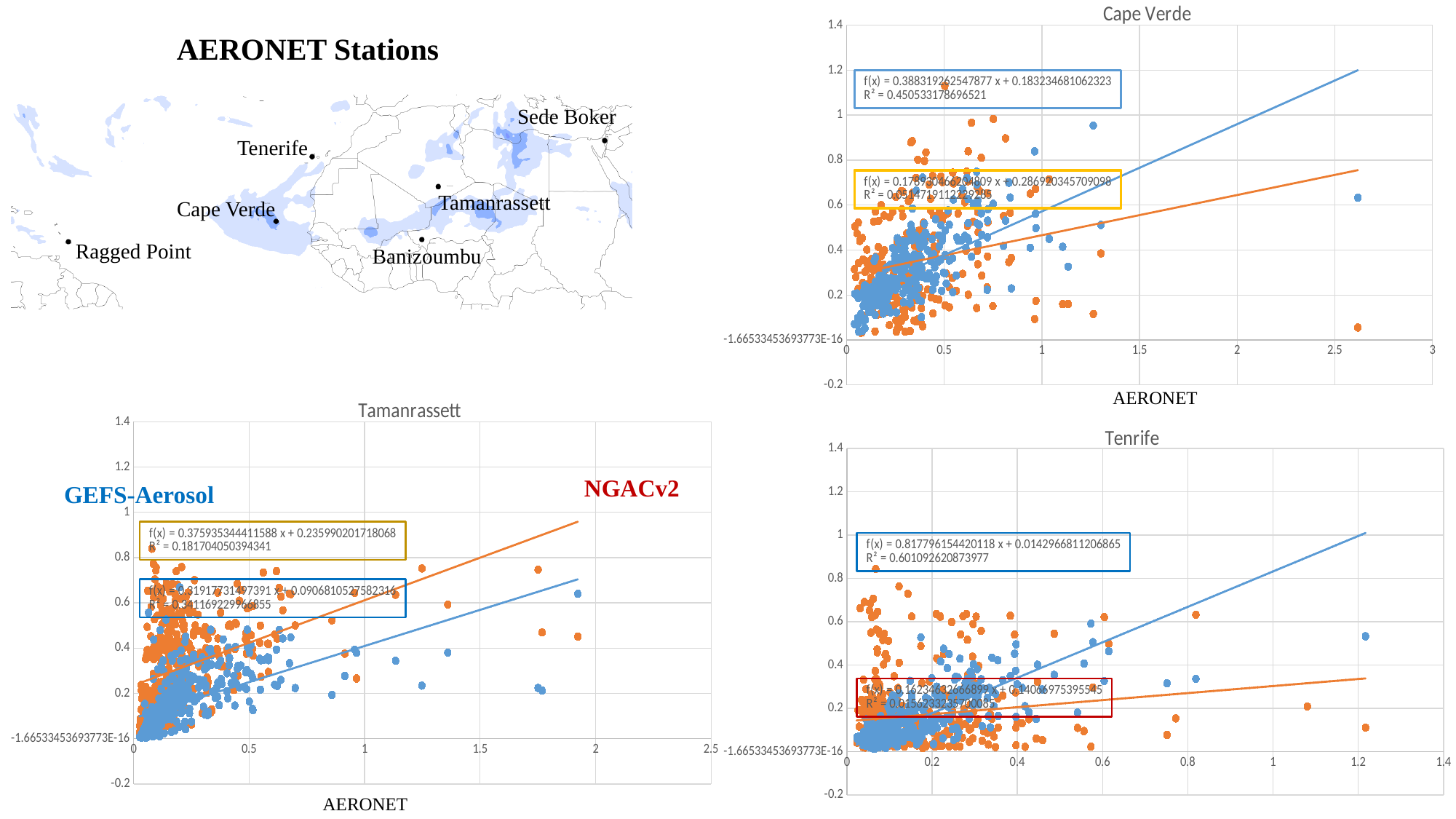
In the Tenrife chart, which fit line is steeper, the blue one or the orange one? blue In the Tenrife chart, what is the R² value shown in the blue box? 0.601092620873977 In the Cape Verde chart, what is the R² value shown in the blue box? 0.450533178696521 What kind of chart is the Cape Verde chart? scatter chart In the Tenrife chart, what is the slope of the fit line given in the blue box? 0.817796154420118 In the Tamanrassett chart, what is the R² value shown in the yellow box? 0.181704050394341 In the Cape Verde chart, what is the slope of the fit line given in the blue box? 0.388319262547877 Which two model series are labelled on the Tamanrassett chart? GEFS-Aerosol and NGACv2 What is the largest x-axis tick value on the Cape Verde chart? 3 What is the x-axis label of the Tamanrassett chart? AERONET How many scatter charts are on the slide? 3 What is the largest x-axis tick value on the Tenrife chart? 1.4